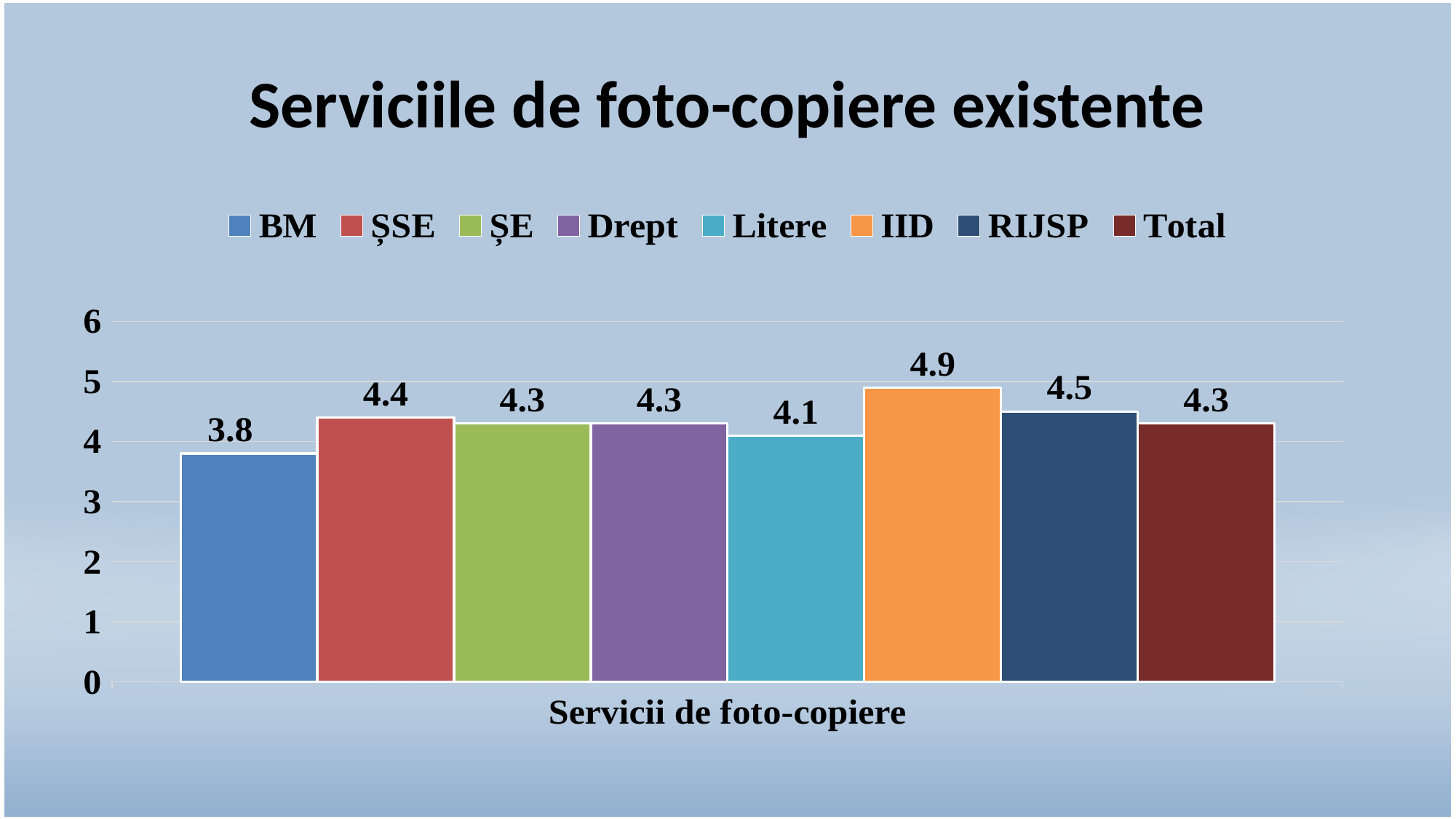
What kind of chart is shown on the slide? bar chart What is the title of the chart? Serviciile de foto-copiere existente Which series has the highest value? IID Which is larger, the value for RIJSP or the value for Drept? RIJSP What is the value for IID? 4.9 Which series has the lowest value? BM What is the difference between the values for IID and BM? 1.1 What is the difference between the values for ȘSE and Litere? 0.3 What is the value for RIJSP? 4.5 How many series does the legend list? 8 What is the value for Litere? 4.1 What is the value for BM? 3.8